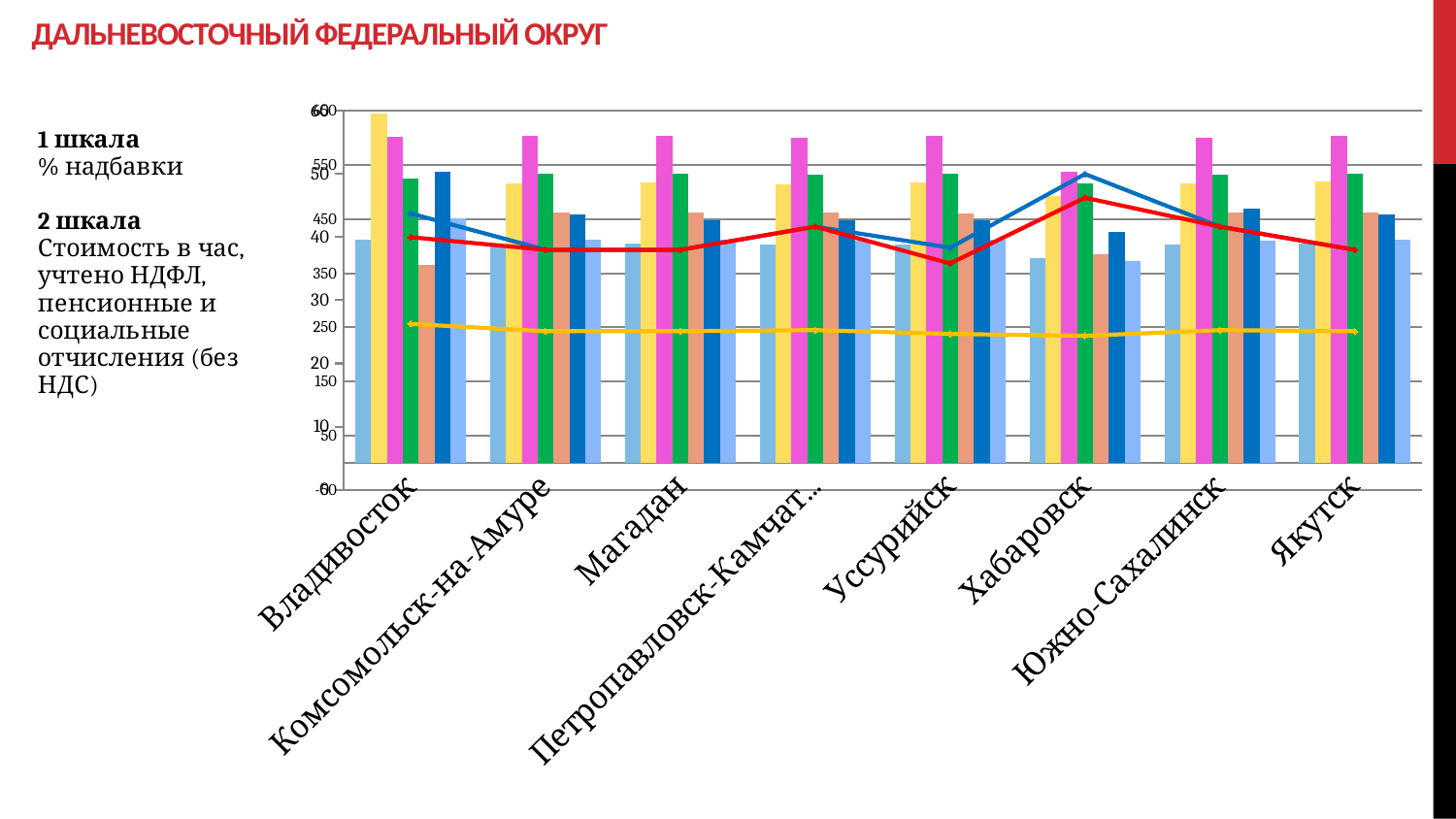
Is the red line higher at Хабаровск or at Уссурийск? Хабаровск At Владивосток, is the pink bar or the orange bar taller? The pink bar Which city has the tallest bar on the chart? Владивосток What is the title of the slide containing the chart? ДАЛЬНЕВОСТОЧНЫЙ ФЕДЕРАЛЬНЫЙ ОКРУГ At which city does the blue line reach its highest point? Хабаровск How many bars are drawn for each city on the chart? 7 What kind of chart is shown on the slide? A combined bar and line chart How many lines are plotted on the chart? 3 How many cities (categories) are shown along the x axis of the chart? 8 Is the value of the yellow line at Владивосток greater or less than 300? less At which city does the red line reach its highest point? Хабаровск Is the yellow bar taller at Владивосток or at Хабаровск? Владивосток